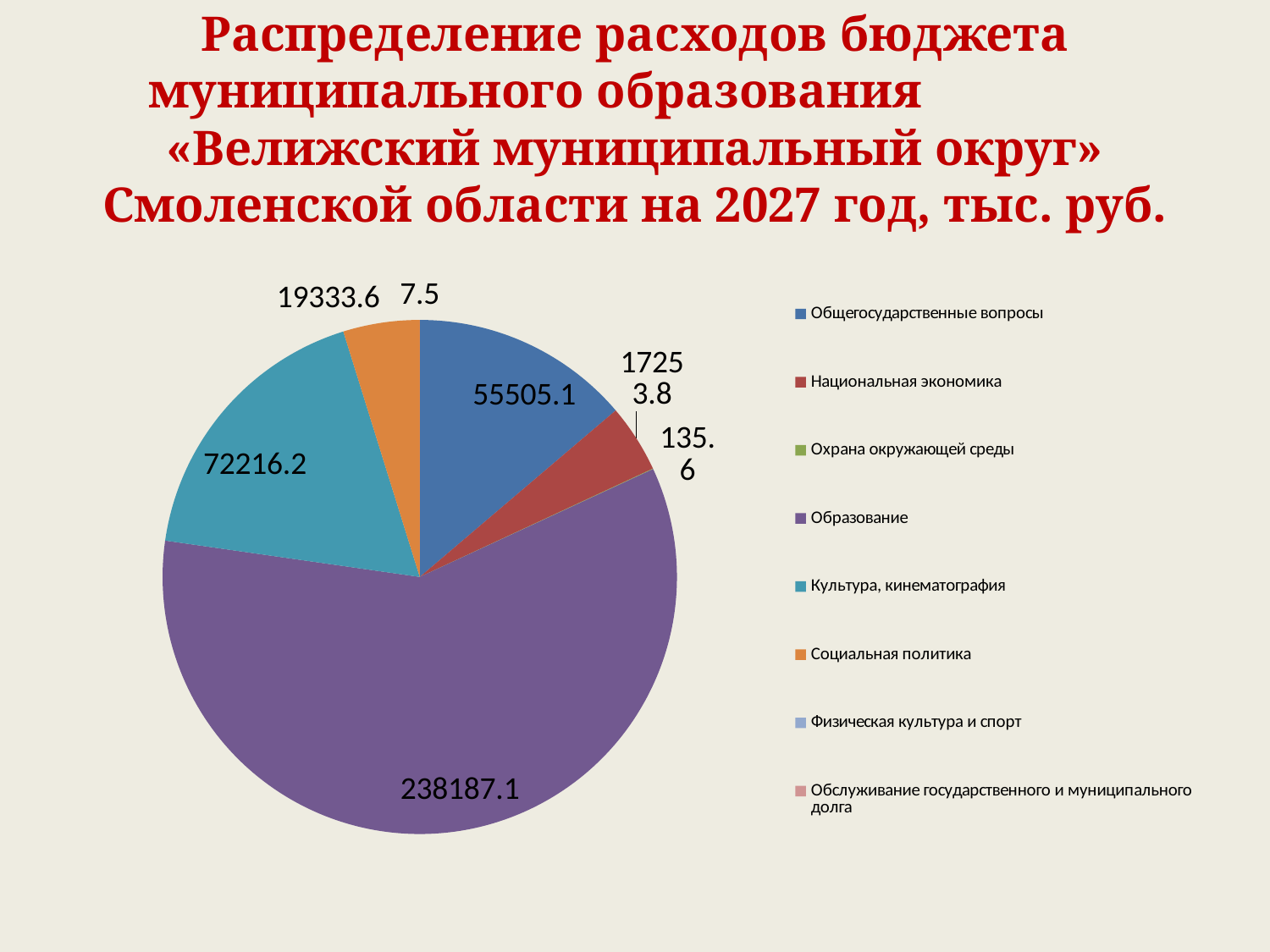
What is the value for Культура, кинематография? 72216.2 How many categories does the legend list? 8 What is the difference between the values for Культура, кинематография and Общегосударственные вопросы? 16711.1 Which category has the largest slice of the pie? Образование What kind of chart is shown on the slide? pie chart What is the value for Социальная политика? 19333.6 What is the value for Общегосударственные вопросы? 55505.1 Which is larger, Культура, кинематография or Общегосударственные вопросы? Культура, кинематография What is the value for Образование? 238187.1 What is the value for Национальная экономика? 17253.8